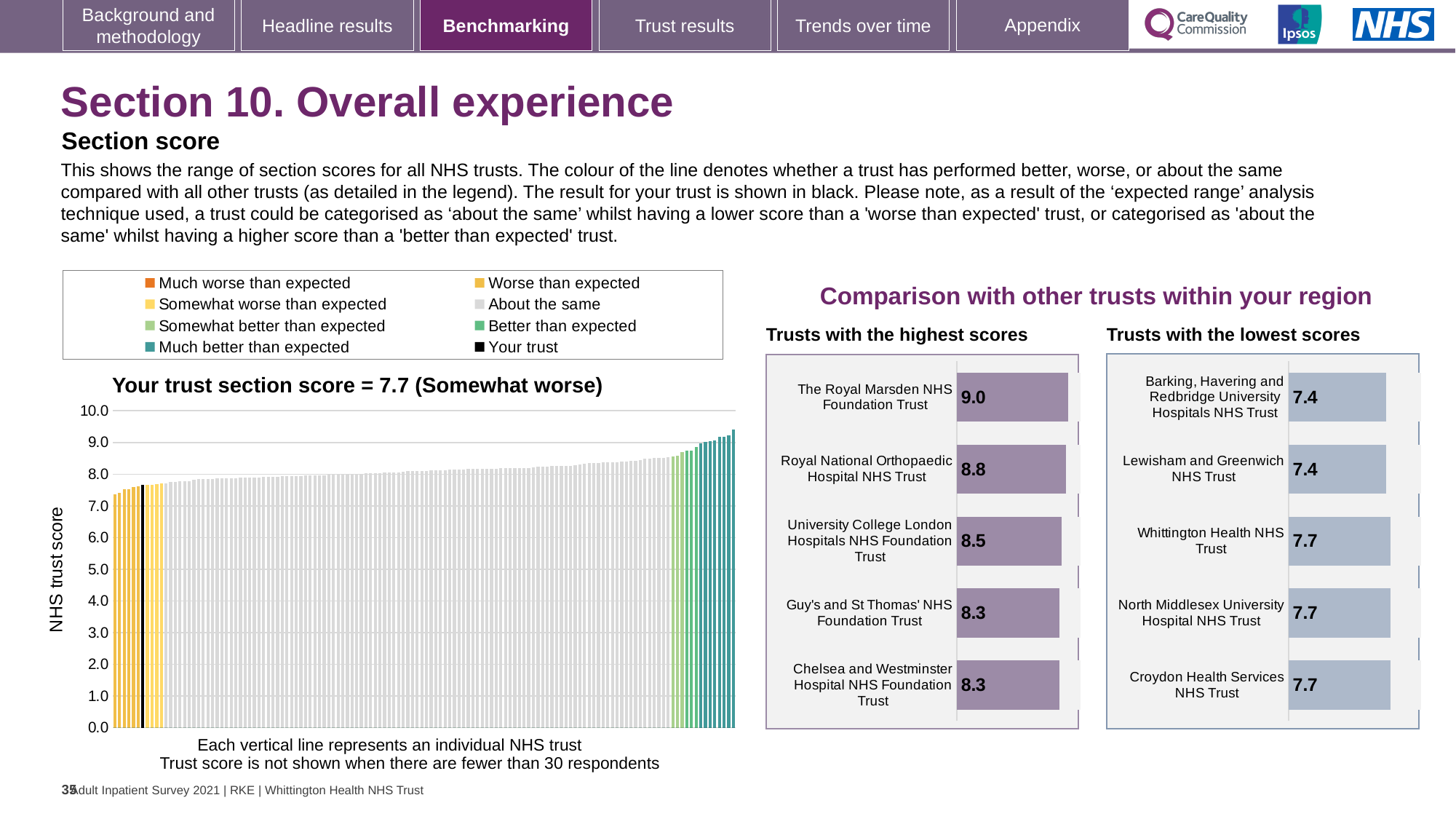
How many entries does the legend above the 'Your trust section score' chart list? 8 In the 'Trusts with the lowest scores' chart, what is the difference between the scores of Whittington Health NHS Trust and Barking, Havering and Redbridge University Hospitals NHS Trust? 0.3 What is the y-axis label of the 'Your trust section score' chart? NHS trust score In the 'Your trust section score' chart, do the bar values rise or fall from left to right? Rise In the 'Your trust section score' chart, what kind of chart is shown? Bar chart In the 'Trusts with the lowest scores' chart, what is the score for Lewisham and Greenwich NHS Trust? 7.4 In the 'Trusts with the highest scores' chart, which trust has the highest score? The Royal Marsden NHS Foundation Trust In the 'Trusts with the highest scores' chart, which has the larger score: The Royal Marsden NHS Foundation Trust or University College London Hospitals NHS Foundation Trust? The Royal Marsden NHS Foundation Trust In the 'Trusts with the highest scores' chart, how many trusts are shown? 5 In the 'Trusts with the highest scores' chart, what is the score for The Royal Marsden NHS Foundation Trust? 9.0 In the 'Your trust section score' chart, what is the section score for your trust? 7.7 In the 'Trusts with the highest scores' chart, what is the difference between the scores of The Royal Marsden NHS Foundation Trust and Royal National Orthopaedic Hospital NHS Trust? 0.2